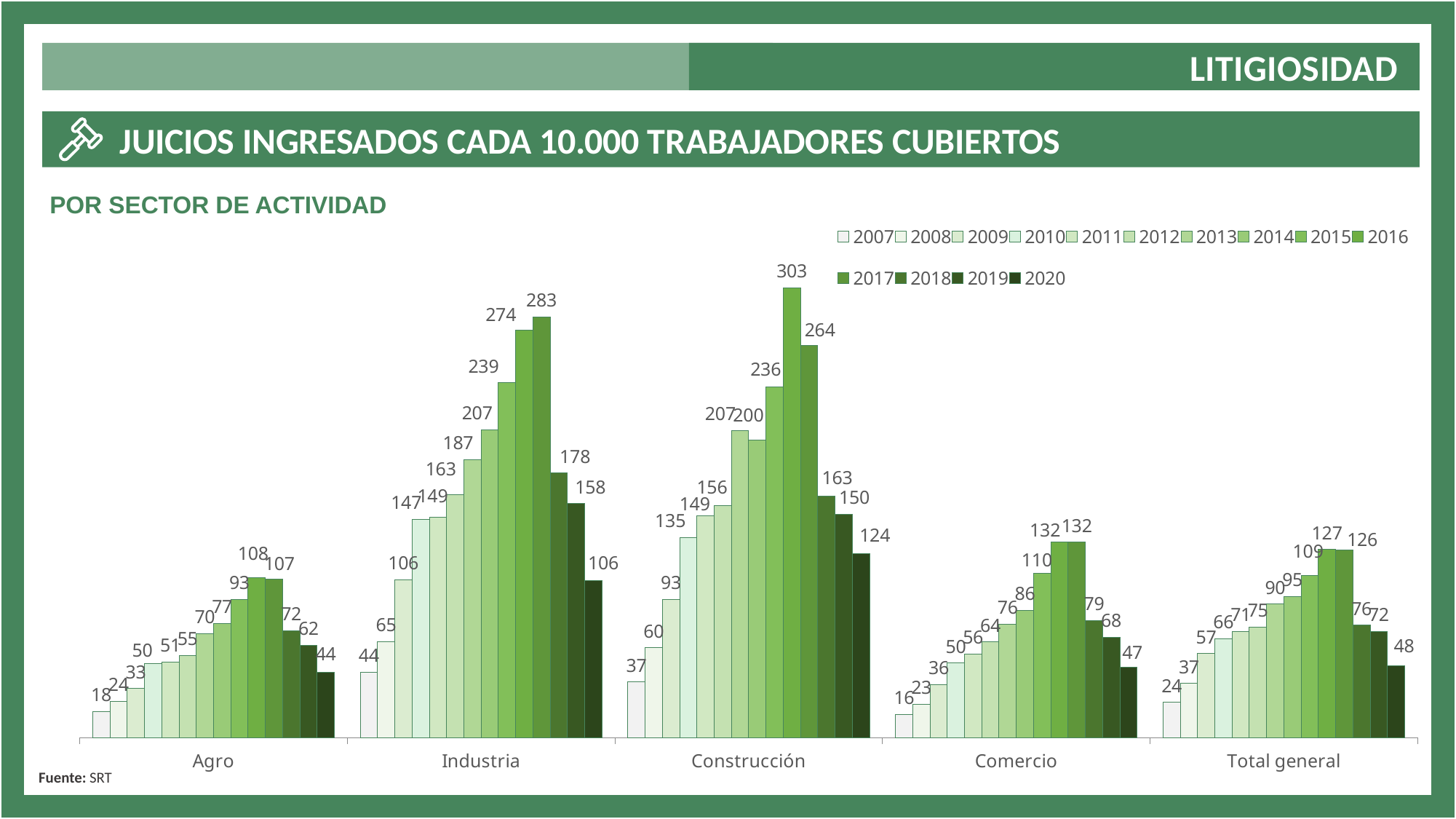
Which sector has the highest value in 2016? Construcción What is the value for Agro in 2020? 44 How many sectors are shown on the x axis? 5 Which sector has the lowest value in 2007? Comercio What is the value for Industria in 2017? 283 What is the difference between the 2016 and 2020 values for Industria? 168 What kind of chart is shown? Bar chart What is the value for Total general in 2007? 24 Which is larger, the 2018 value for Construcción or the 2018 value for Industria? Industria How many series does the legend list? 14 What is the source cited for the chart? SRT What is the value for Construcción in 2016? 303